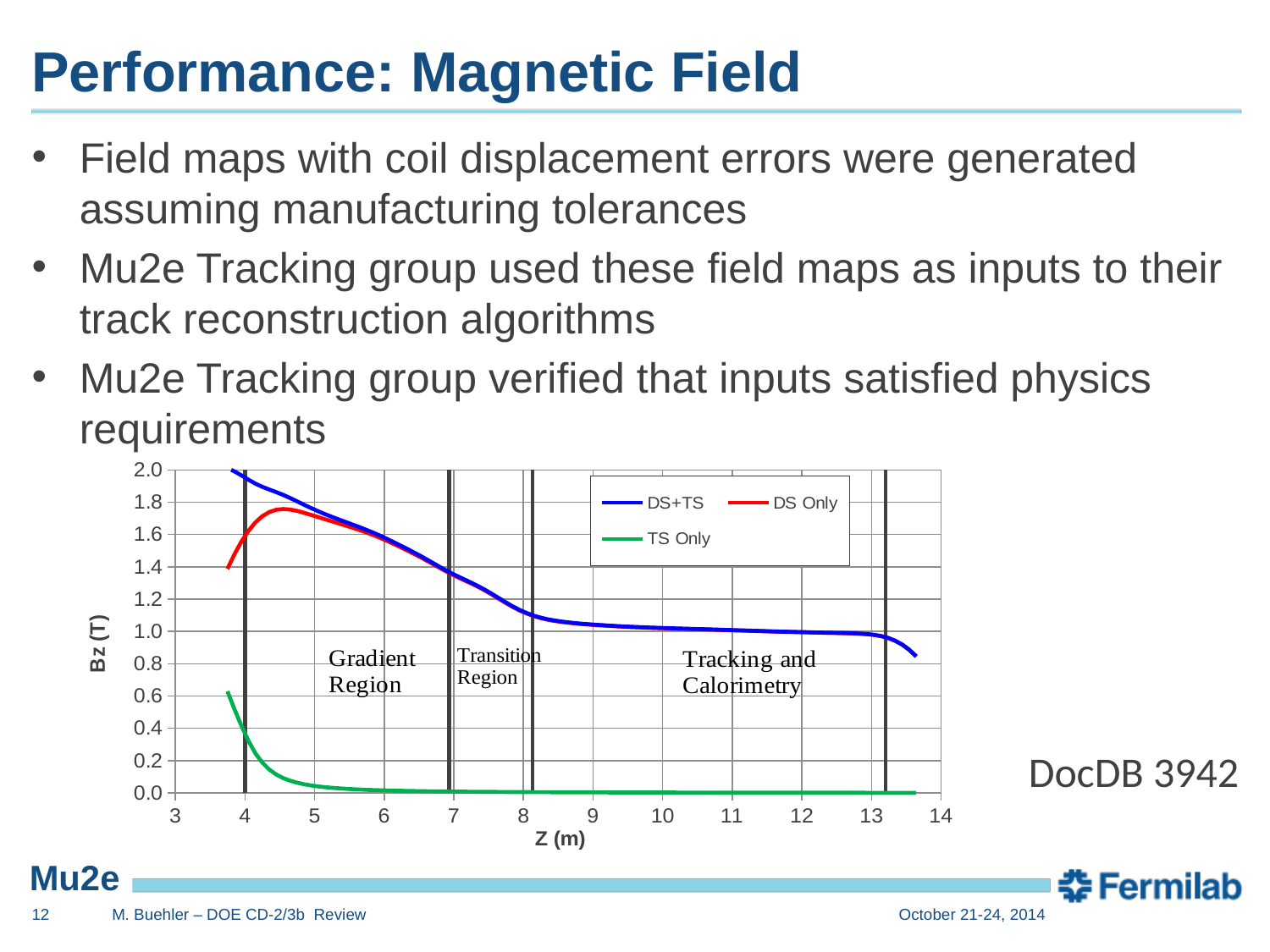
Does the TS Only series rise or fall as Z increases? fall Is the TS Only value at Z = 6 m greater or less than 0.2? less What is the label of the chart's x axis? Z (m) What are the three series named in the chart legend? DS+TS, DS Only, TS Only At Z = 5 m, which series has the larger value, DS+TS or TS Only? DS+TS Is the DS Only value at Z = 4 m greater or less than 1.4? greater Is the DS+TS value at Z = 4 m greater or less than 1.8? greater Which series has the lowest value at Z = 8 m? TS Only How many series does the chart legend list? 3 What kind of chart is shown on the slide? line chart At Z = 4 m, which series has the larger value, DS+TS or DS Only? DS+TS